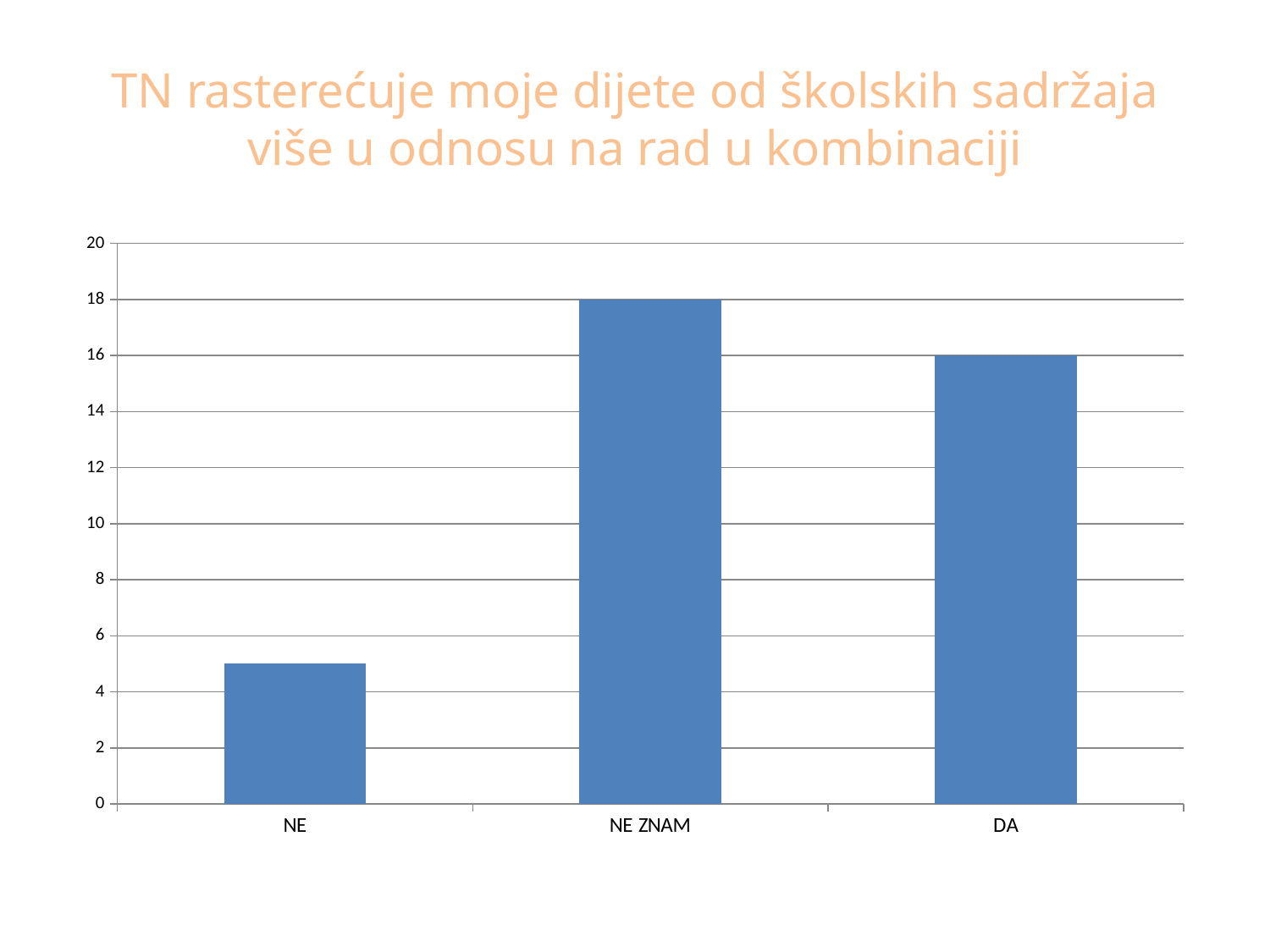
Which is larger, the value for DA or the value for NE ZNAM? NE ZNAM What is the title of the slide? TN rasterećuje moje dijete od školskih sadržaja više u odnosu na rad u kombinaciji Is the value for NE greater or less than 10? less Which category has the lowest value? NE What is the difference between the values for NE ZNAM and DA? 2 How many categories are shown on the x axis? 3 What kind of chart is shown on the slide? bar chart What is the value for NE ZNAM? 18 What is the value for DA? 16 Which category has the highest value? NE ZNAM Is the value for NE greater or less than 4? greater Which is larger, the value for NE or the value for DA? DA